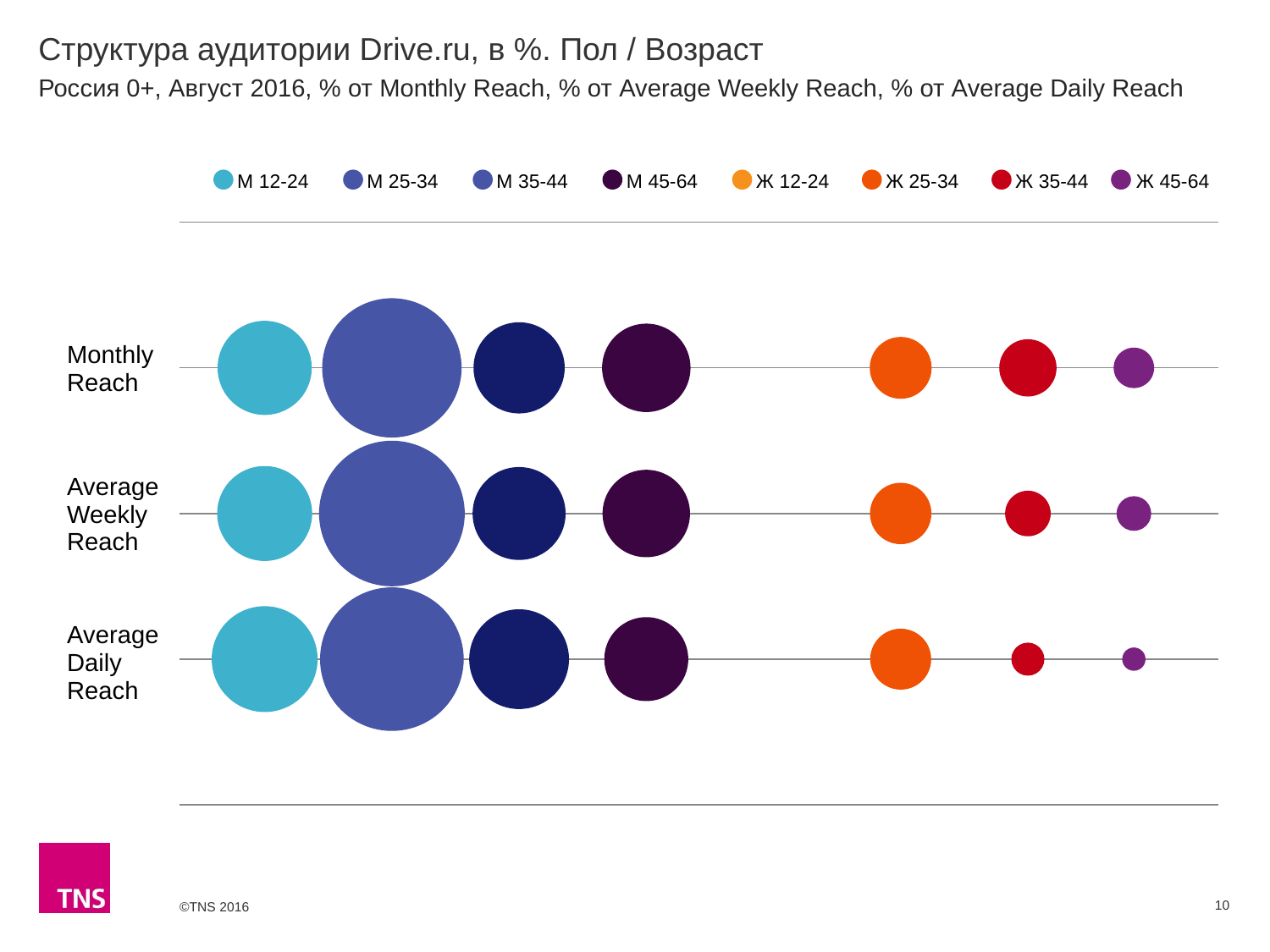
Which series has the largest bubble in the Monthly Reach row? М 25-34 In the Average Weekly Reach row, which bubble is larger: М 25-34 or М 35-44? М 25-34 What kind of chart is shown on the slide? bubble chart In the Average Daily Reach row, which bubble is larger: Ж 25-34 or Ж 35-44? Ж 25-34 How many series does the legend list? 8 How many reach categories (rows) are plotted on the chart? 3 What is the title of the chart on the slide? Структура аудитории Drive.ru, в %. Пол / Возраст Does the Ж 45-64 bubble get larger or smaller going from Monthly Reach to Average Daily Reach? smaller Does the Ж 35-44 bubble get larger or smaller going from Monthly Reach to Average Daily Reach? smaller Which series has the largest bubble in the Average Daily Reach row? М 25-34 In the Monthly Reach row, which bubble is larger: М 12-24 or Ж 45-64? М 12-24